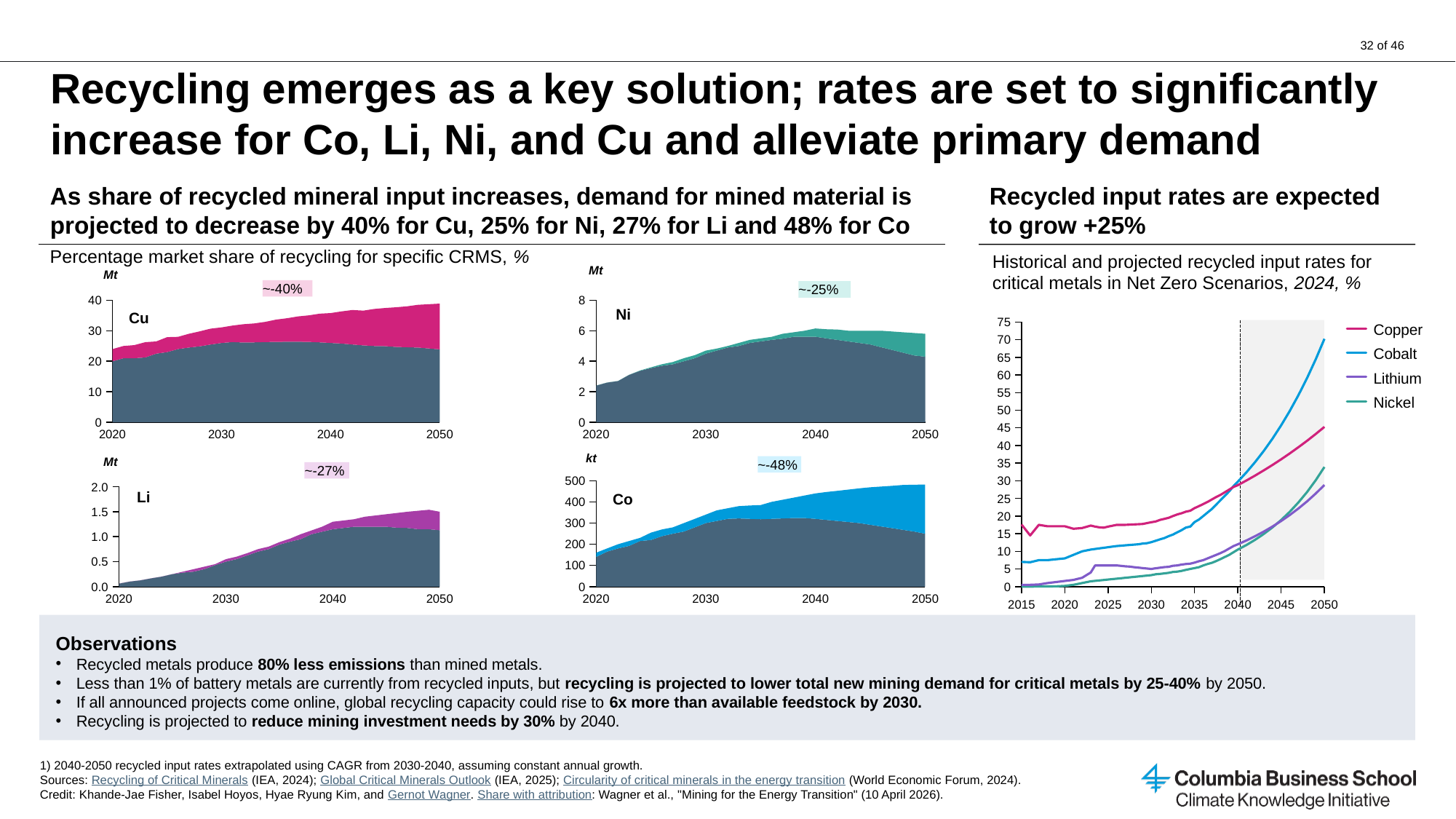
What kind of chart is the Cu chart on the left of the slide? Area chart In the recycled input rates chart on the right, is the value for Cobalt in 2050 greater or less than 60? greater What reduction is annotated above the Co chart? ~-48% In the recycled input rates chart on the right, does the Cobalt line rise or fall from 2015 to 2050? Rises In the recycled input rates chart on the right, is the value for Nickel in 2020 greater or less than 5? less How many series does the legend of the recycled input rates chart on the right list? 4 What reduction is annotated above the Cu chart? ~-40% In the recycled input rates chart on the right, which metal has the highest value in 2050? Cobalt In the recycled input rates chart on the right, which metal has the highest value in 2015? Copper What kind of chart is the 'Historical and projected recycled input rates' chart on the right of the slide? Line chart In the recycled input rates chart on the right, which is larger in 2050: Copper or Nickel? Copper In the recycled input rates chart on the right, is the value for Copper in 2050 greater or less than 50? less